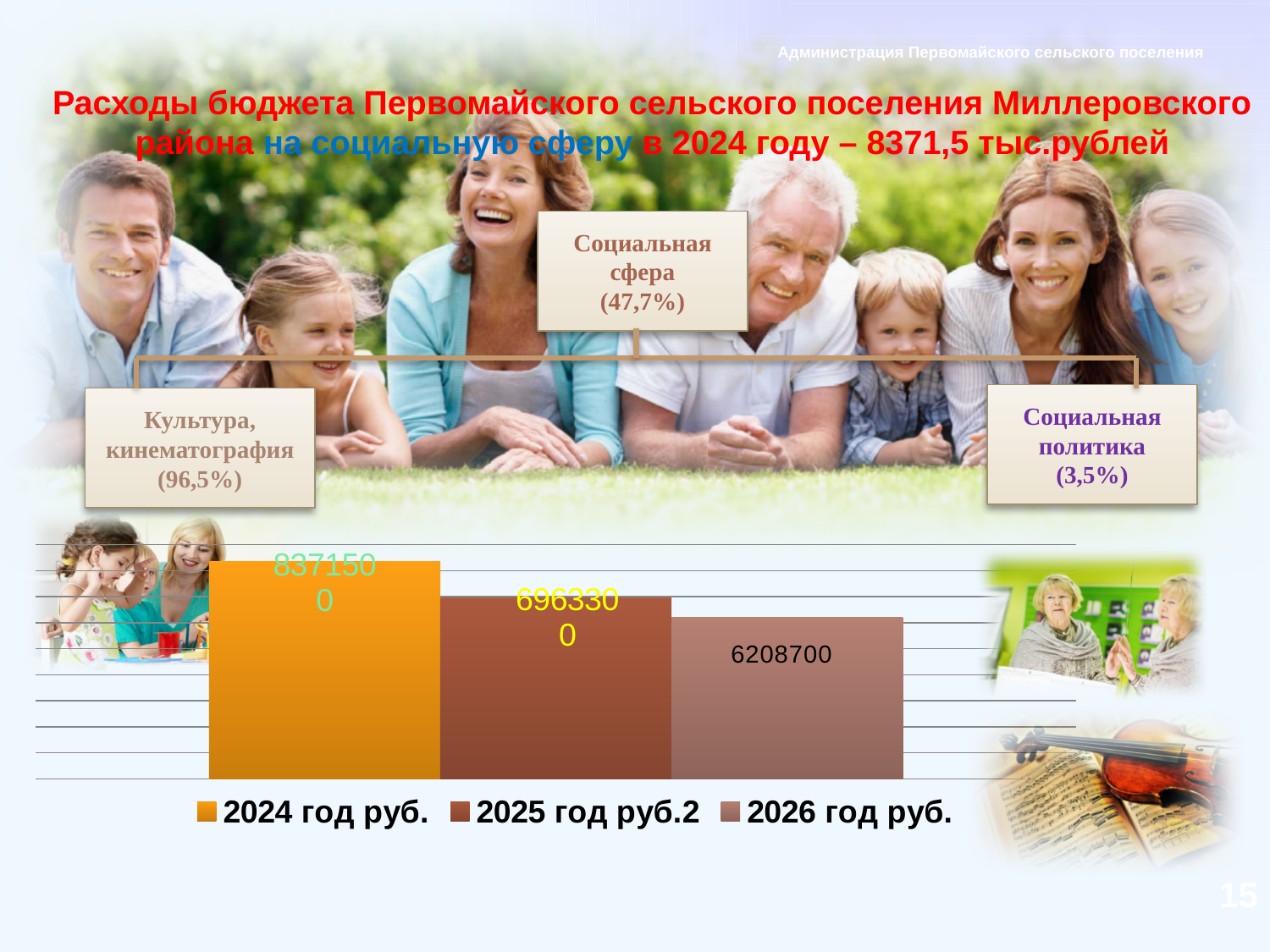
Which series has the lowest value in the bar chart? 2026 год руб. Which series has the highest value in the bar chart? 2024 год руб. Which is larger in the bar chart: the value for "2024 год руб." or the value for "2026 год руб."? 2024 год руб. What is the value for the series "2026 год руб." in the bar chart? 6208700 How many series does the legend of the bar chart list? 3 What kind of chart is shown on the slide? bar chart What is the value for the series "2025 год руб.2" in the bar chart? 6963300 Do the values in the bar chart rise or fall from 2024 to 2026? fall What is the value for the series "2024 год руб." in the bar chart? 8371500 What colour is the bar for "2024 год руб." in the bar chart? orange What is the difference between the values for "2024 год руб." and "2025 год руб.2" in the bar chart? 1408200 What is the difference between the values for "2025 год руб.2" and "2026 год руб." in the bar chart? 754600